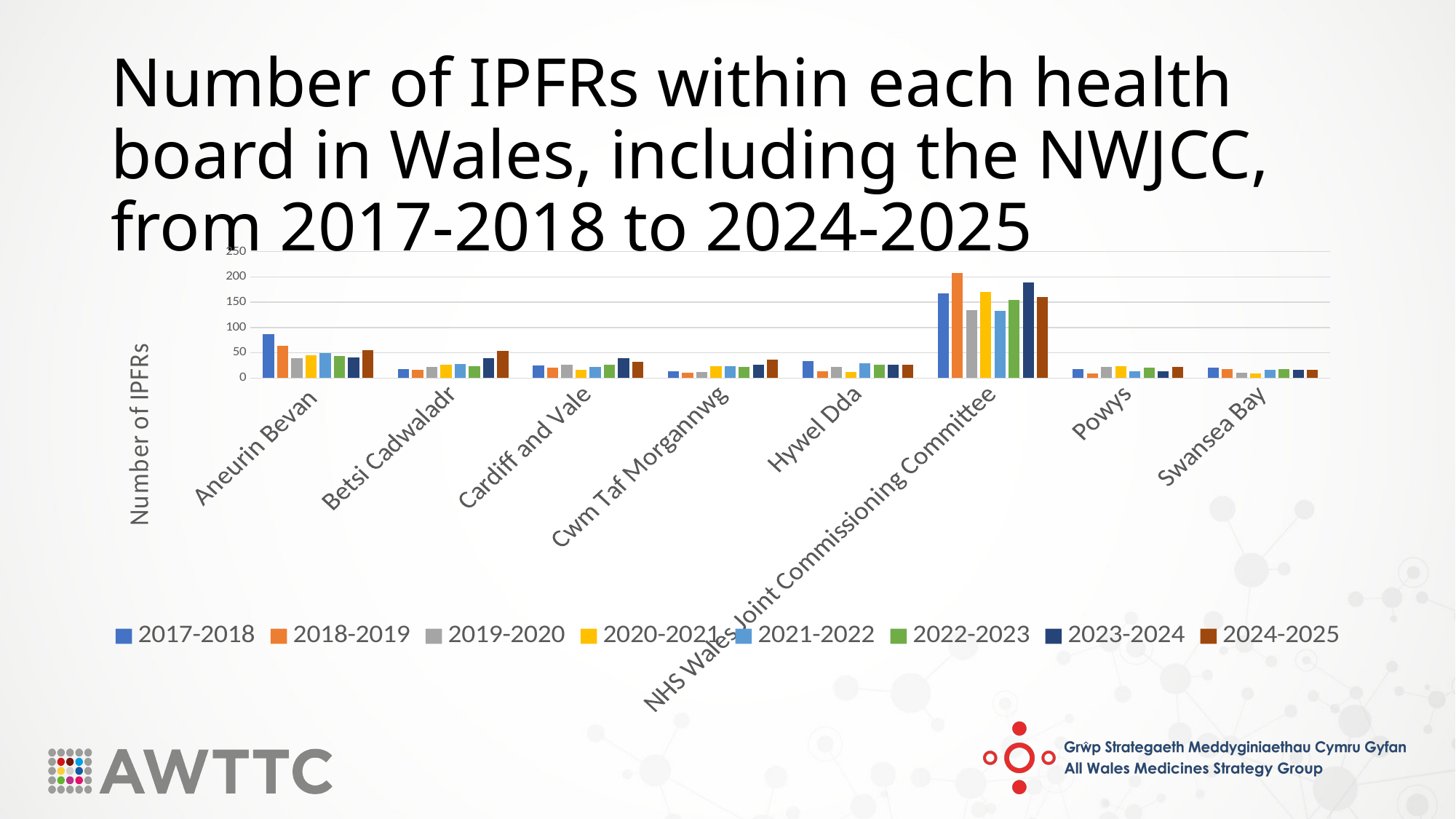
Which legend entry is shown in orange? 2018-2019 How many series (years) does the chart legend list? 8 For Aneurin Bevan, which is larger: the 2017-2018 value or the 2018-2019 value? 2017-2018 What is the label on the vertical axis of the chart? Number of IPFRs Is the 2017-2018 value for Aneurin Bevan greater or less than 100? less Is the 2019-2020 value for NHS Wales Joint Commissioning Committee greater or less than 150? less Is the 2018-2019 value for NHS Wales Joint Commissioning Committee greater or less than 200? greater For NHS Wales Joint Commissioning Committee, which year has the highest number of IPFRs? 2018-2019 How many health boards/organisations are shown along the x axis of the chart? 8 Which health board or organisation has the highest number of IPFRs in the chart? NHS Wales Joint Commissioning Committee What kind of chart is shown on the slide? Bar chart